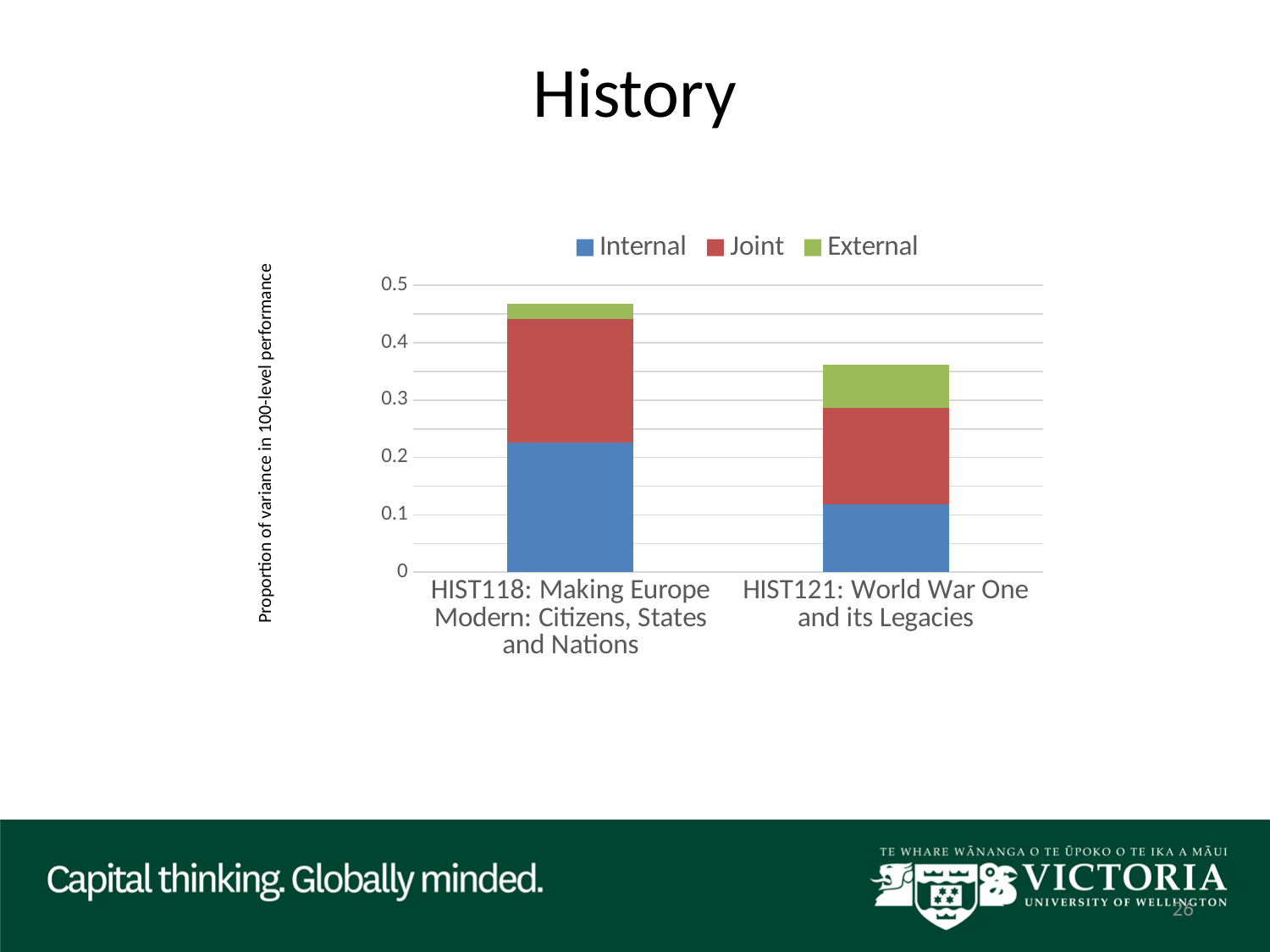
What is the title of the chart's vertical axis? Proportion of variance in 100-level performance Which course has the larger Internal segment, HIST118 or HIST121? HIST118 Is the Internal value for HIST121: World War One and its Legacies greater or less than 0.2? less How many series does the chart's legend list? 3 Which colour represents the Joint series in the chart? Red Is the total stacked value for HIST121: World War One and its Legacies greater or less than 0.4? less Is the Internal value for HIST118: Making Europe Modern greater or less than 0.2? greater How many courses (categories) are shown on the x axis of the chart? 2 Which course has the larger External segment, HIST118 or HIST121? HIST121 What kind of chart is shown on the slide? Stacked bar chart Which course has the taller stacked bar overall? HIST118: Making Europe Modern: Citizens, States and Nations